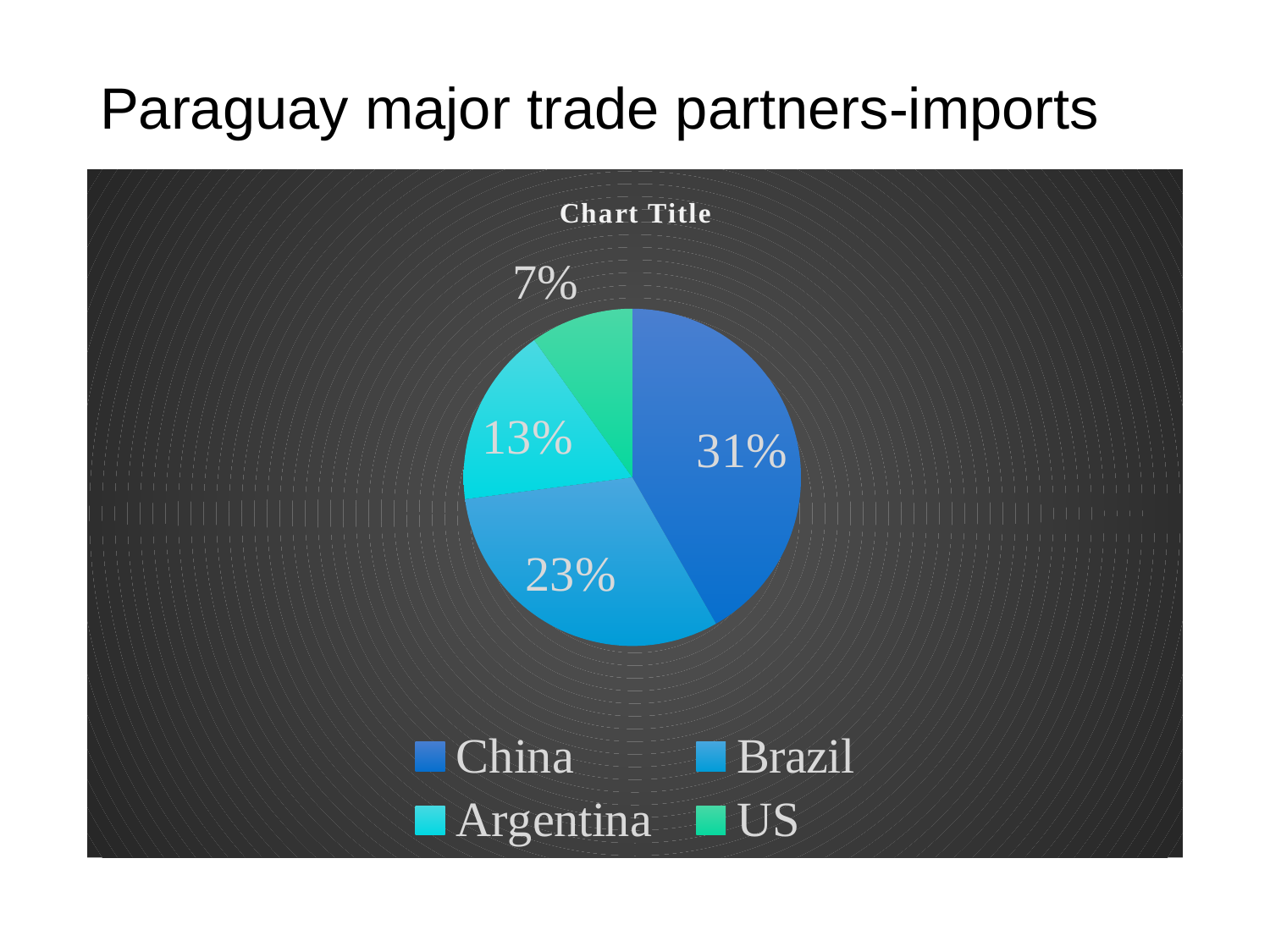
How many entries does the legend list? 4 Which trade partner has the smallest share of the pie? US What percentage of the pie does the US account for? 7% What percentage of the pie does China account for? 31% What percentage of the pie does Argentina account for? 13% What is the difference in percentage points between China's share and Brazil's share? 8 Which trade partner has the largest share of the pie? China How many trade partners are shown in the pie chart? 4 What percentage of the pie does Brazil account for? 23% What is the title printed above the pie chart? Chart Title What kind of chart is shown on the slide? pie chart Which has a larger share, Argentina or the US? Argentina